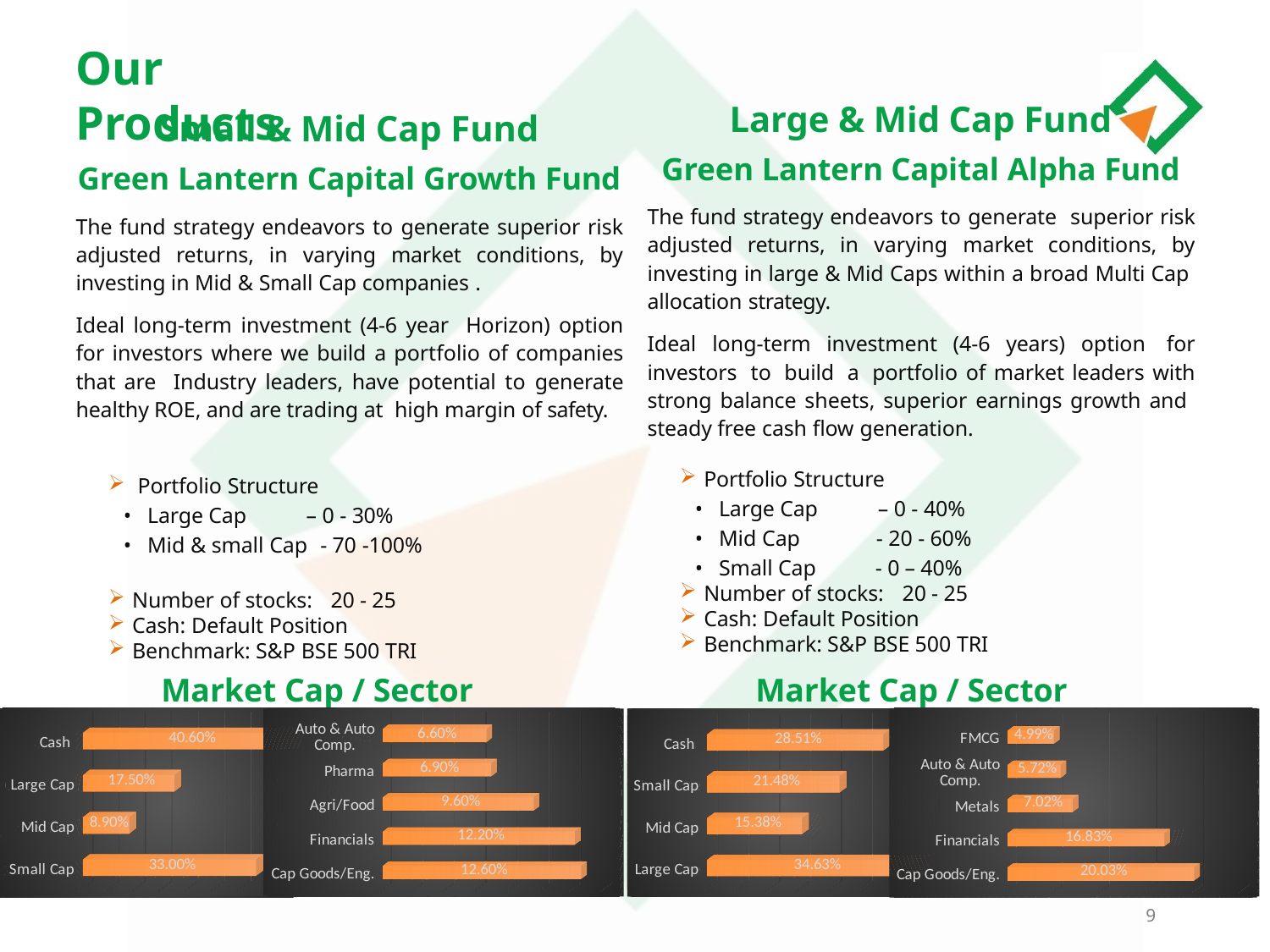
In the Growth Fund's sector chart (bottom left, second chart), which sector has the highest value? Cap Goods/Eng. In the Growth Fund's sector chart (bottom left, second chart), what is the value for Financials? 12.20% What type of chart is used for the Growth Fund's market cap breakdown (bottom left)? Bar chart In the Alpha Fund's market cap chart (bottom right), what is the value for Large Cap? 34.63% In the Alpha Fund's market cap chart (bottom right), which category has the highest value? Large Cap In the Alpha Fund's sector chart (bottom right, second chart), what is the value for Metals? 7.02% In the Alpha Fund's market cap chart (bottom right), what is the difference between Cash and Mid Cap? 13.13% In the Alpha Fund's sector chart (bottom right, second chart), which sector has the lowest value? FMCG In the Alpha Fund's sector chart (bottom right, second chart), which is larger, Financials or Cap Goods/Eng.? Cap Goods/Eng. In the Growth Fund's market cap chart (bottom left), which category has the lowest value? Mid Cap In the Growth Fund's sector chart (bottom left, second chart), how many sectors are shown? 5 In the Growth Fund's market cap chart (bottom left), what is the value for Cash? 40.60%